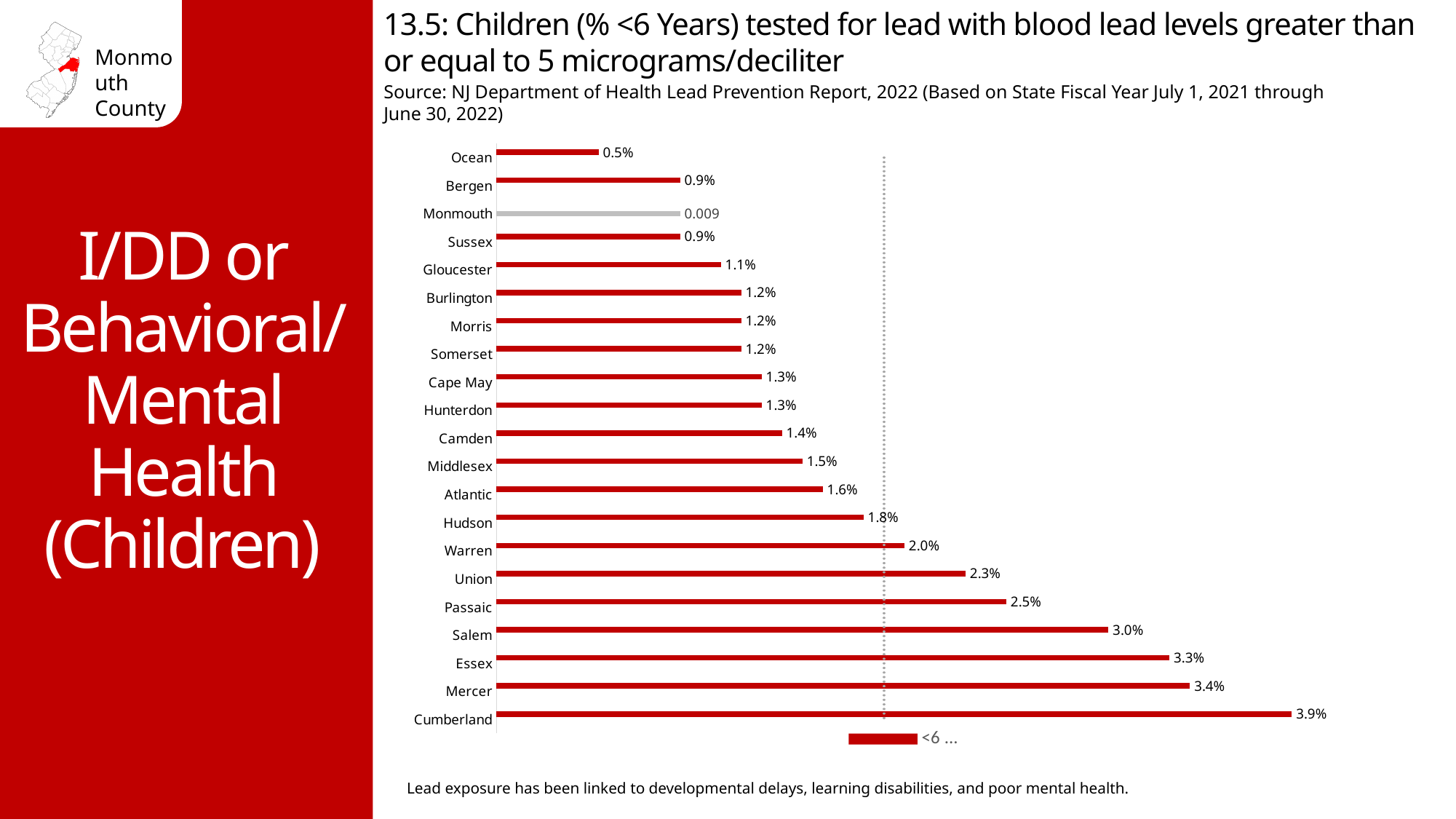
What is the value for Cumberland? 3.9% Which county has the highest value? Cumberland What is the difference between the values for Essex and Salem? 0.3% What kind of chart is shown on the slide? bar chart How many counties are shown in the chart? 21 Which county's bar is drawn in grey rather than red? Monmouth Which is larger, the value for Warren or the value for Camden? Warren How many series does the legend list? 1 What is the difference between the values for Cumberland and Mercer? 0.5% Which county has the lowest value? Ocean What is the value for Hudson? 1.8% What value is printed for Monmouth? 0.009